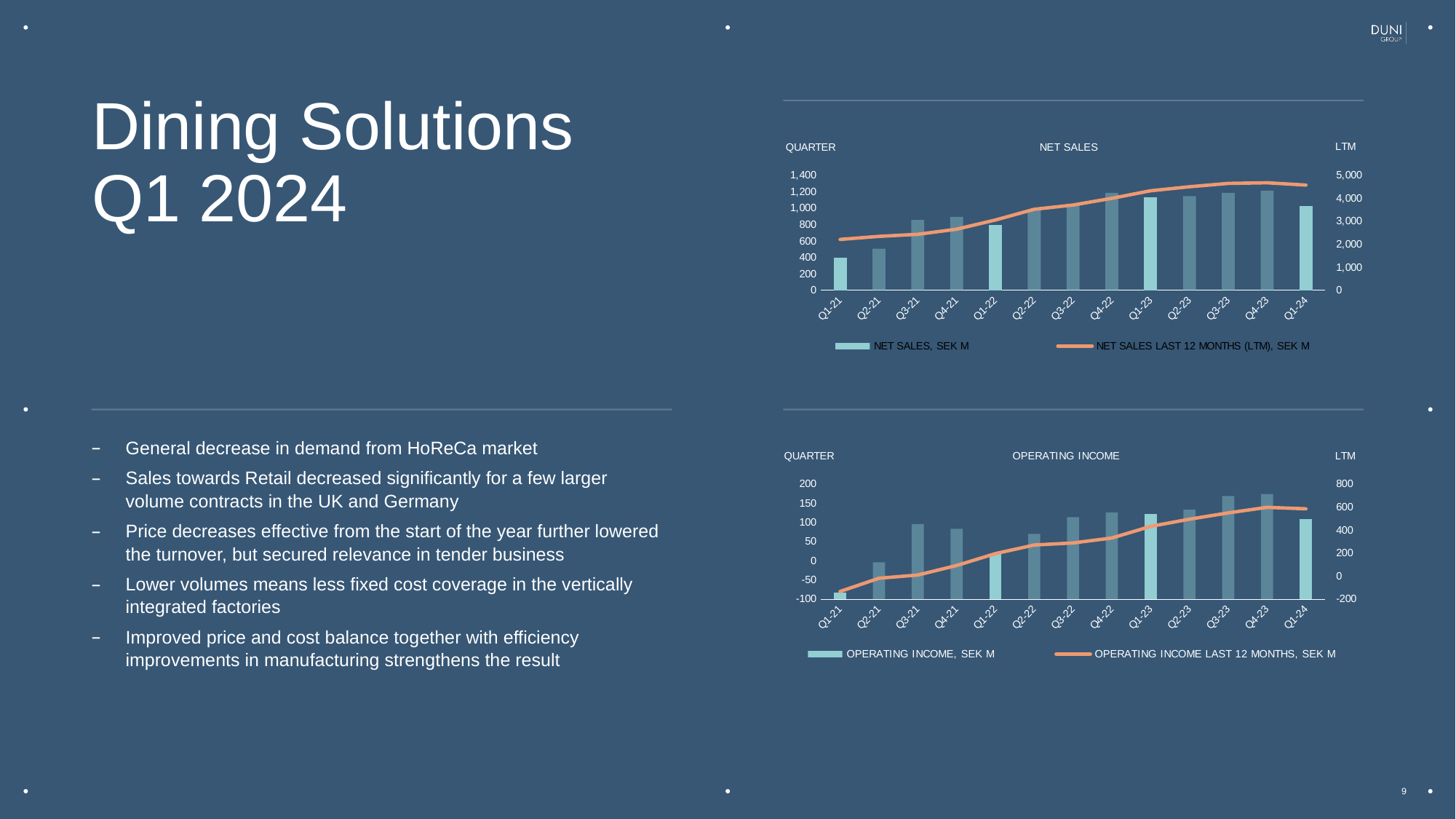
What kind of chart is the OPERATING INCOME chart? Bar chart with a line In the OPERATING INCOME chart, which quarter has the larger operating income bar, Q1-21 or Q3-21? Q3-21 In the OPERATING INCOME chart, is the operating income for Q1-21 greater or less than 0? less In the NET SALES chart, how many quarters are shown on the x axis? 13 In the OPERATING INCOME chart, which quarter has the lowest operating income bar? Q1-21 In the NET SALES chart, does the LTM line generally rise or fall from Q1-21 to Q4-23? rise In the OPERATING INCOME chart, is the operating income for Q3-23 greater or less than 150? greater In the NET SALES chart, which quarter has the lowest net sales bar? Q1-21 In the NET SALES chart, is the net sales value for Q1-21 greater or less than 600? less In the NET SALES chart, how many series does the legend list? 2 In the NET SALES chart, which quarter has the larger net sales bar, Q1-21 or Q1-24? Q1-24